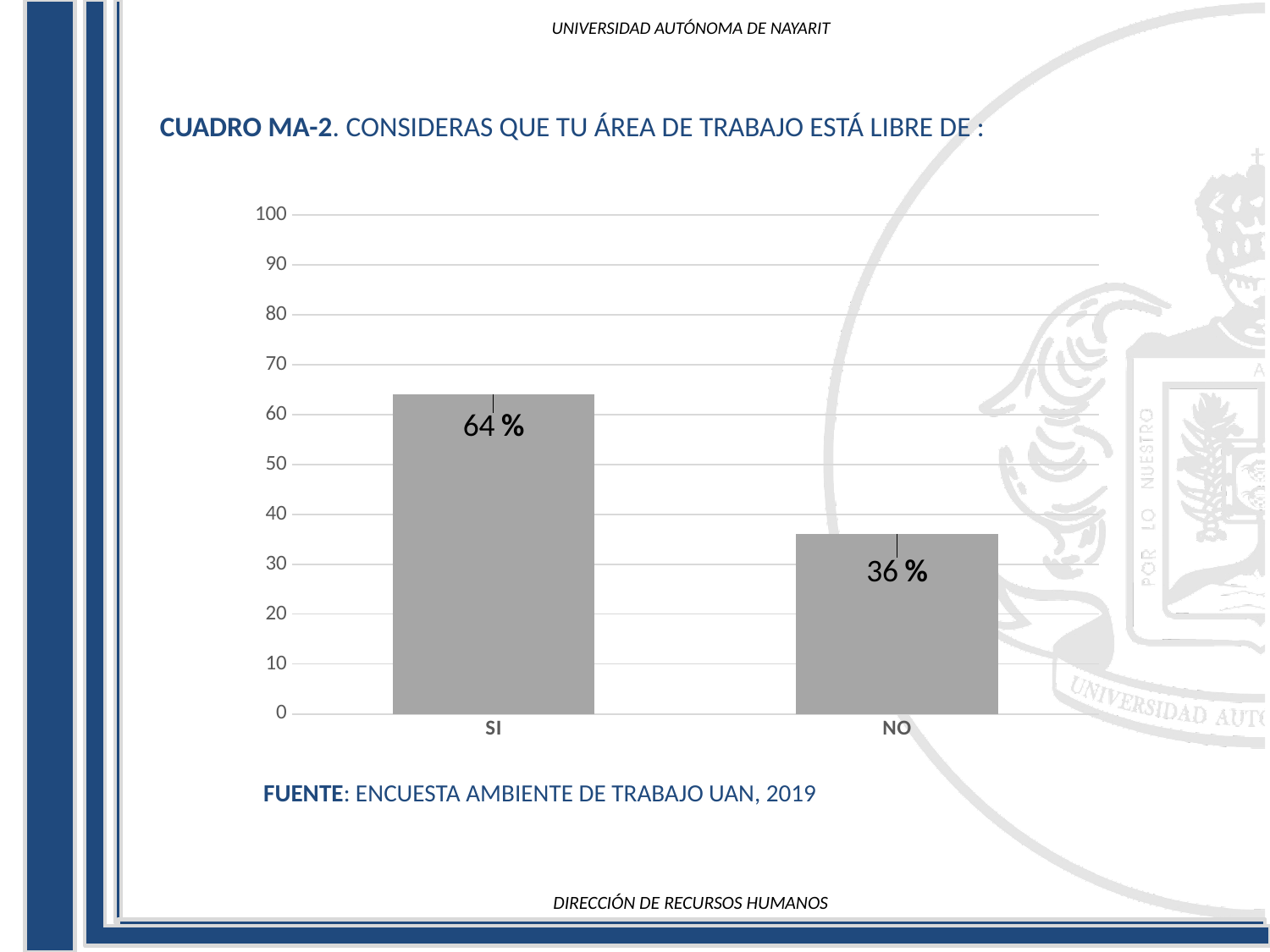
Which is larger, the value for SI or the value for NO? SI What is the value for SI? 64 % Which category has the lowest value? NO What is the source cited below the chart? ENCUESTA AMBIENTE DE TRABAJO UAN, 2019 How many categories are shown in the chart? 2 Is the value for SI greater or less than 60? greater What is the maximum value shown on the vertical axis? 100 What is the difference between the values for SI and NO? 28 % What kind of chart is shown on the slide? bar chart Is the value for NO greater or less than 40? less Which category has the highest value? SI What is the value for NO? 36 %